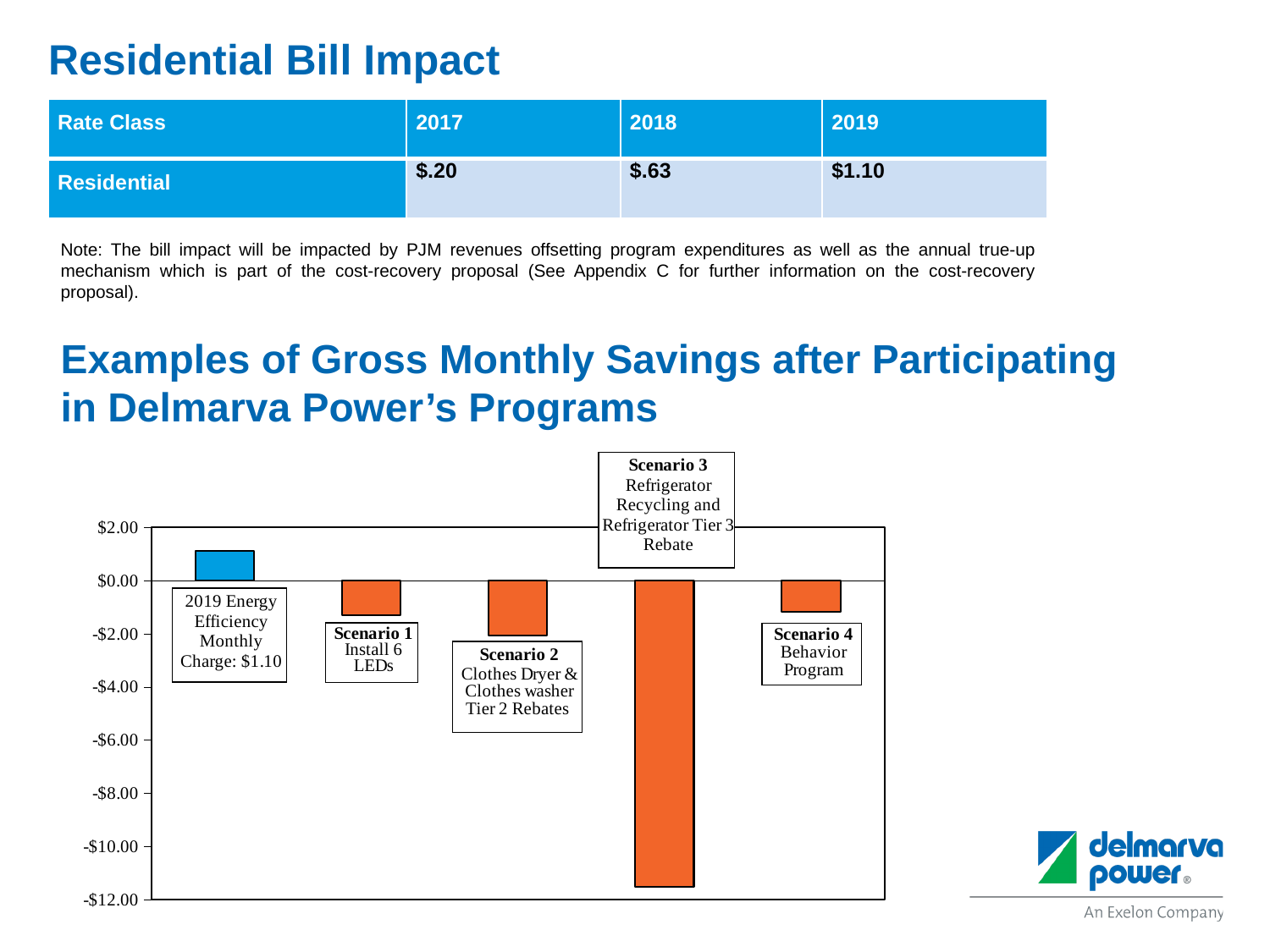
What is the value of the 2019 Energy Efficiency Monthly Charge bar in the chart? $1.10 What colour is the 2019 Energy Efficiency Monthly Charge bar in the chart? blue What kind of chart is shown under the heading 'Examples of Gross Monthly Savings after Participating in Delmarva Power's Programs'? bar chart How many scenarios are shown in the chart? 4 How many bars are plotted in the chart? 5 Is the value for Scenario 1 (Install 6 LEDs) greater or less than -$2.00? greater Which has the lower value in the chart, Scenario 2 or Scenario 3? Scenario 3 Which bar in the chart has the highest value? 2019 Energy Efficiency Monthly Charge Is the value for Scenario 4 (Behavior Program) greater or less than -$2.00? greater Which bar in the chart has the lowest value? Scenario 3 (Refrigerator Recycling and Refrigerator Tier 3 Rebate) Is the value for Scenario 3 greater or less than -$10.00? less Which scenario in the chart is labelled 'Behavior Program'? Scenario 4